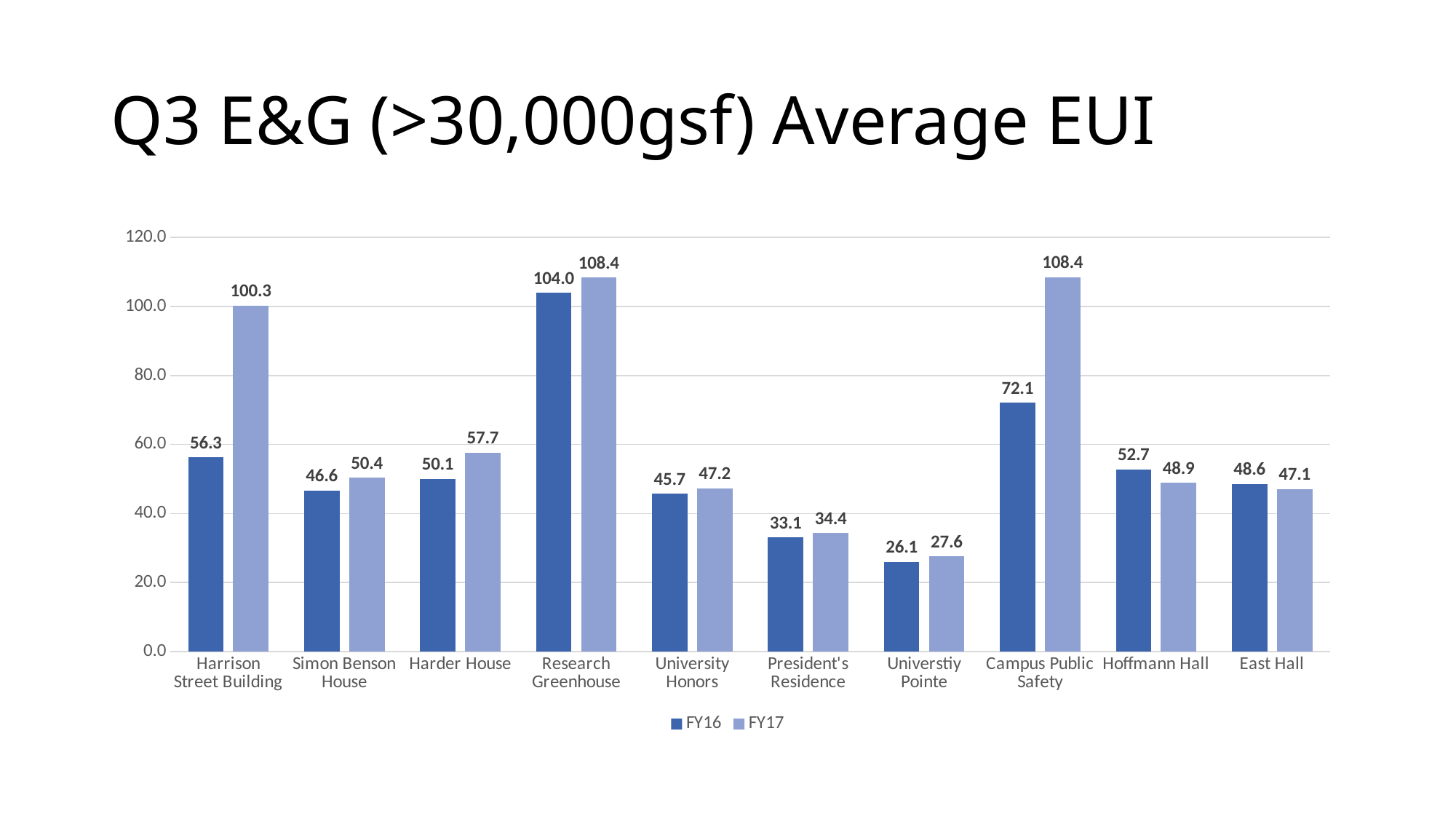
How many buildings are shown on the x axis? 10 Is the FY16 value for Research Greenhouse greater or less than 100.0? greater Which building has the lowest FY17 value? Universtiy Pointe What is the FY16 value for University Pointe? 26.1 What is the difference between the FY17 and FY16 values for Harrison Street Building? 44.0 Which building has the highest FY16 value? Research Greenhouse How many series does the legend list? 2 What is the difference between the FY17 and FY16 values for Campus Public Safety? 36.3 Which is larger for Hoffmann Hall, the FY16 value or the FY17 value? FY16 What kind of chart is shown on the slide? Bar chart What is the FY16 value for Campus Public Safety? 72.1 What is the FY17 value for Harrison Street Building? 100.3